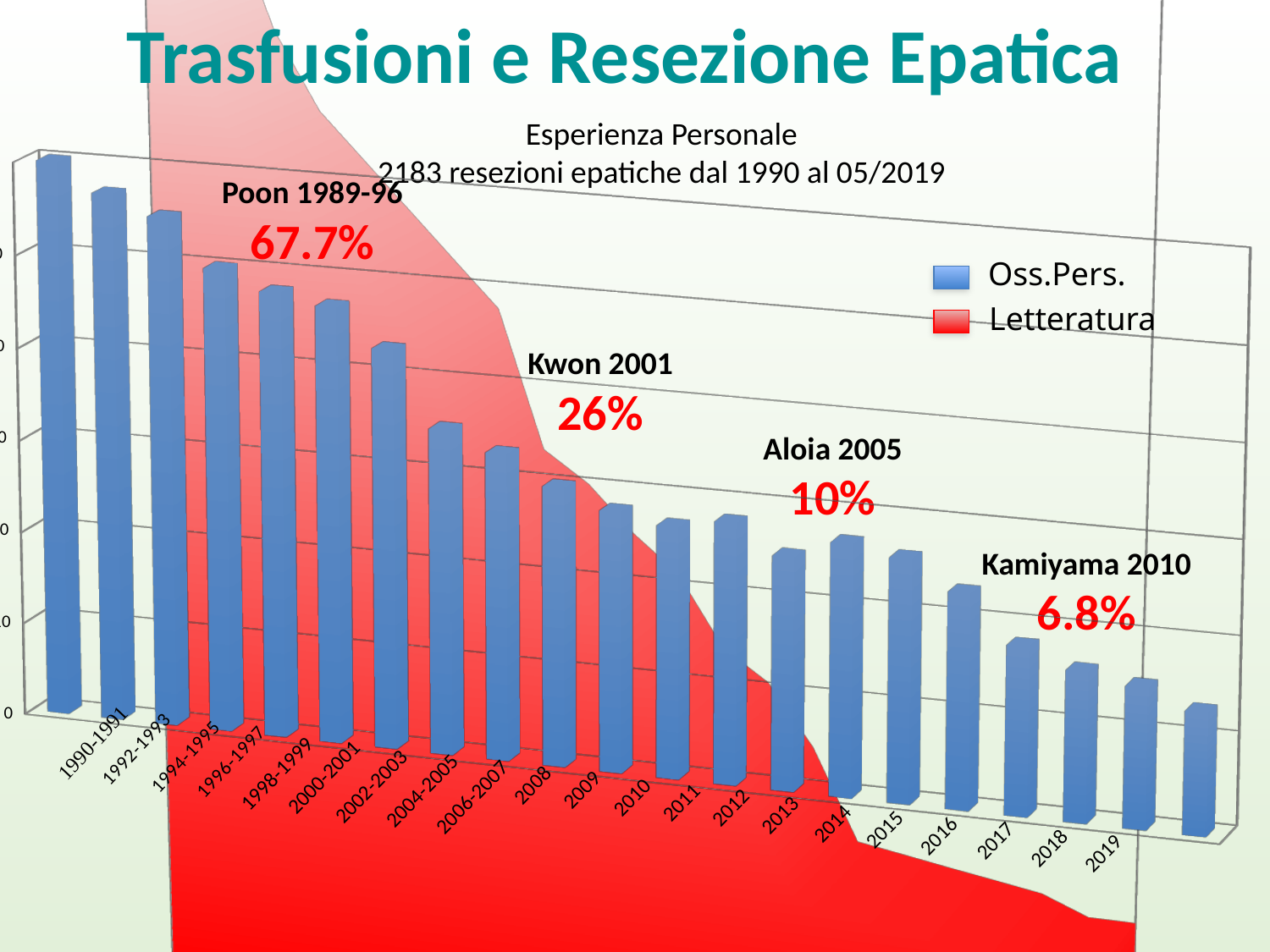
What percentage is shown for Kamiyama 2010? 6.8% Which has the larger Oss.Pers. bar, 1994-1995 or 2004-2005? 1994-1995 Which category has the lowest Oss.Pers. bar? 2019 What percentage is shown for Kwon 2001? 26% Which legend entry is shown in red? Letteratura What percentage is shown for Poon 1989-96? 67.7% Do the Oss.Pers. values rise or fall from 1990-1991 to 2019? fall Which category has the highest Oss.Pers. bar? 1990-1991 How many categories are shown on the x axis? 21 Which has the larger Oss.Pers. bar, 2008 or 2013? 2008 How many series does the legend list? 2 What kind of chart is shown on the slide? bar chart